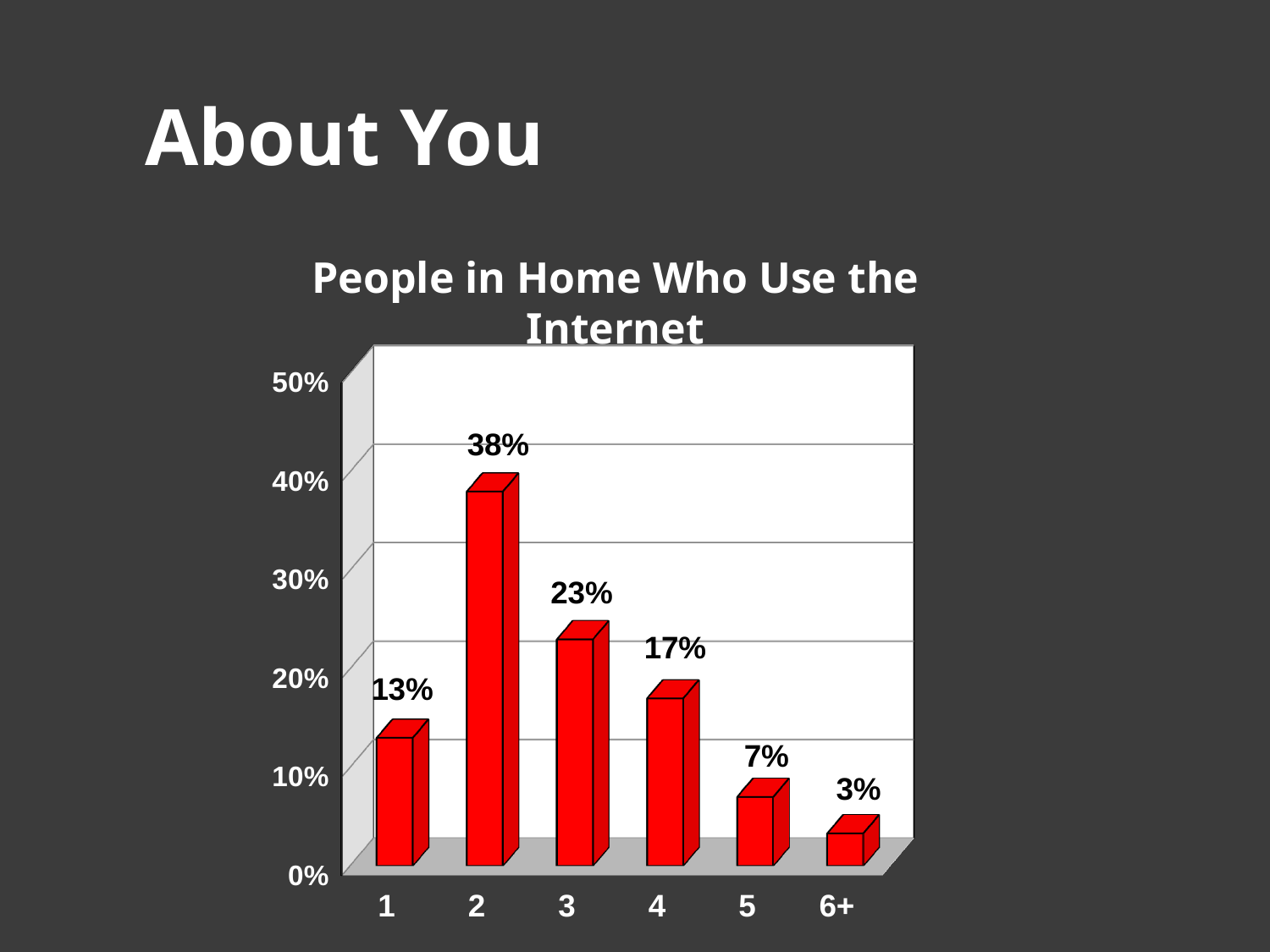
What is the value shown for the category 6+? 3% What kind of chart is shown on the slide? Bar chart Which is larger, the value for 1 person or the value for 4 people? 4 people Which category has the lowest value? 6+ What is the title of the chart? People in Home Who Use the Internet Which category has the highest value? 2 Is the value for 3 people greater or less than 20%? greater What is the difference between the values for 2 and 3 people? 15% What percentage of respondents have 2 people in the home who use the internet? 38% How many categories are shown on the x axis? 6 What is the difference between the values for 1 and 5 people? 6% What percentage is shown for 4 people in the home who use the internet? 17%